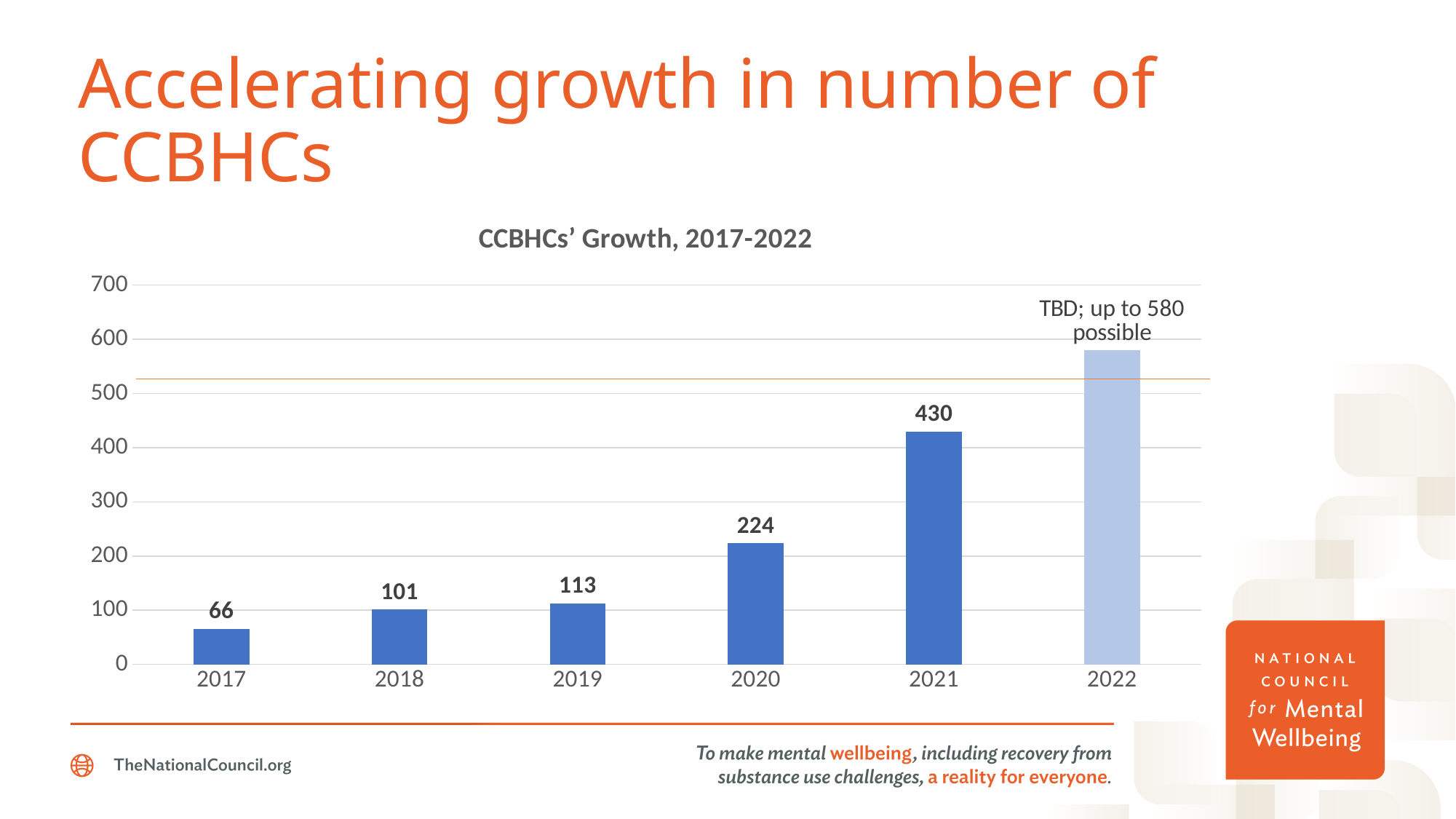
How many years are shown on the x axis? 6 What is the value for 2019? 113 Which year has the lowest value? 2017 Is the value for 2022 greater or less than 500? greater Among the years with exact values printed (2017-2021), which year has the highest value? 2021 Which is larger, the value for 2019 or the value for 2018? 2019 What is the difference between the values for 2018 and 2017? 35 What label is shown above the 2022 bar? TBD; up to 580 possible What is the value for 2021? 430 What is the difference between the values for 2021 and 2020? 206 What is the value for 2017? 66 What kind of chart is shown on the slide? bar chart